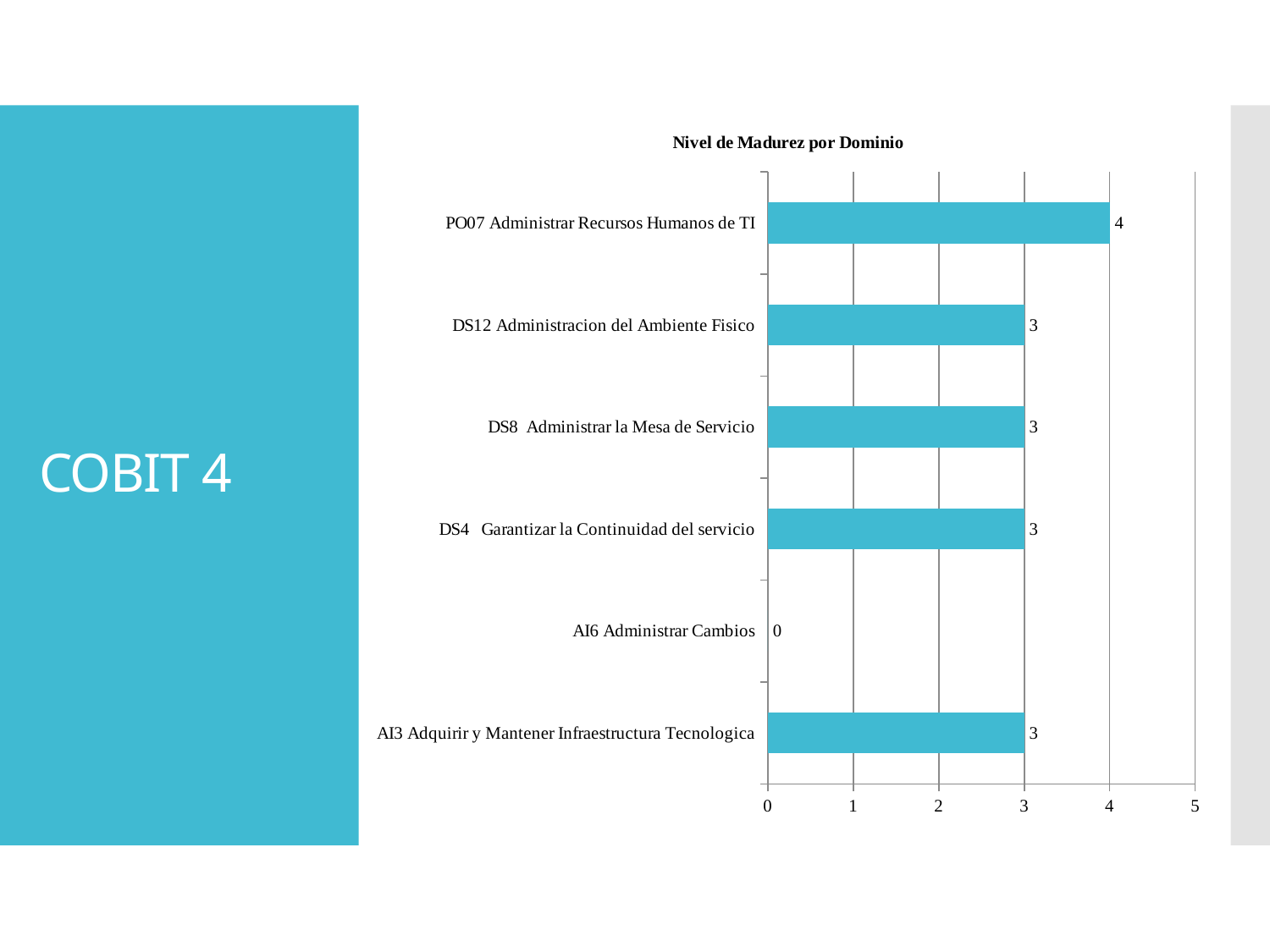
What kind of chart is shown on the slide? Bar chart What is the title of the chart? Nivel de Madurez por Dominio Which category has the highest value? PO07 Administrar Recursos Humanos de TI Which is larger, the value for DS4 Garantizar la Continuidad del servicio or the value for AI6 Administrar Cambios? DS4 Garantizar la Continuidad del servicio How many categories are shown in the chart? 6 What is the value for AI6 Administrar Cambios? 0 What is the value for AI3 Adquirir y Mantener Infraestructura Tecnologica? 3 What is the value for DS12 Administracion del Ambiente Fisico? 3 What is the value for PO07 Administrar Recursos Humanos de TI? 4 What is the difference between the values for PO07 Administrar Recursos Humanos de TI and DS8 Administrar la Mesa de Servicio? 1 What is the maximum value shown on the horizontal axis? 5 Which category has the lowest value? AI6 Administrar Cambios